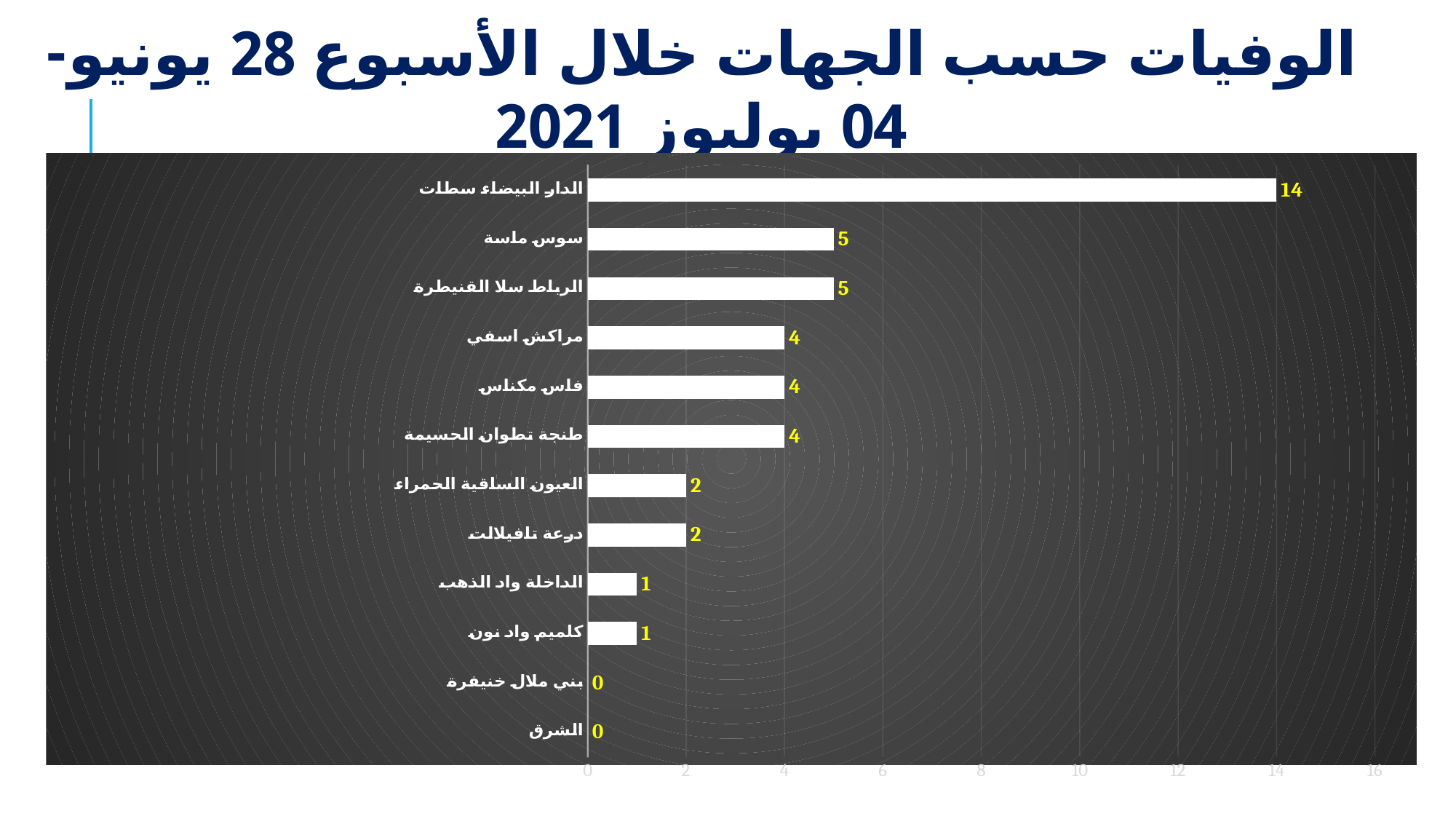
What value is shown for درعة تافيلالت? 2 What value is shown for سوس ماسة? 5 What value is shown for طنجة تطوان الحسيمة? 4 What value is shown for الدار البيضاء سطات? 14 Is the value for الدار البيضاء سطات greater or less than 10? greater Which is larger, the value for مراكش اسفي or the value for العيون الساقية الحمراء? مراكش اسفي How many regions are shown in the chart? 12 What value is shown for الشرق? 0 What is the difference between the values for الدار البيضاء سطات and الرباط سلا القنيطرة? 9 What kind of chart is shown on the slide? bar chart What is the difference between the values for فاس مكناس and كلميم واد نون? 3 Which region has the highest value? الدار البيضاء سطات